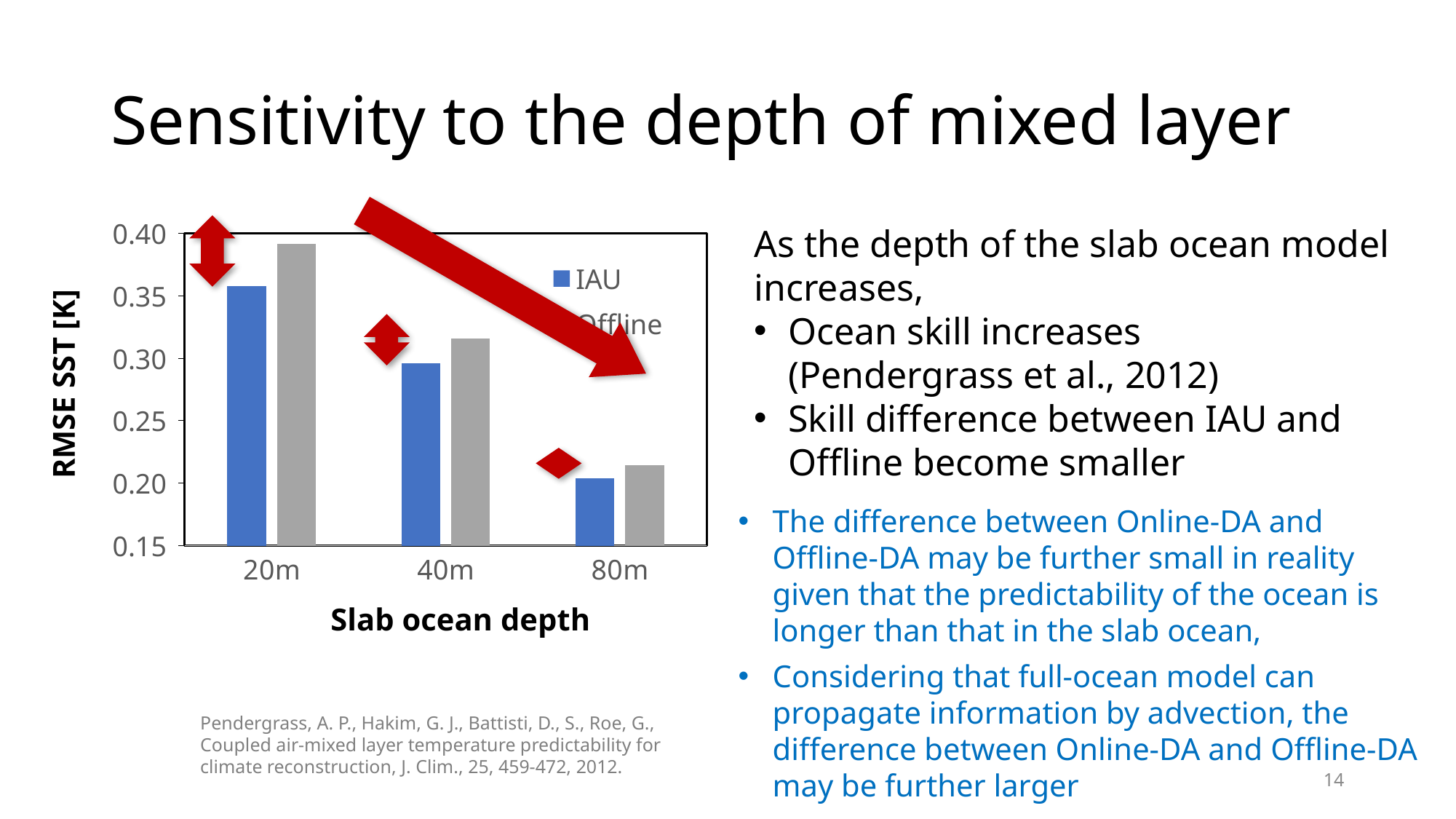
Is the Offline value at 80m greater or less than 0.25? less What is the label of the vertical axis of the chart? RMSE SST [K] Is the Offline value at 20m greater or less than 0.35? greater How many series does the chart legend list? 2 Do the RMSE SST values rise or fall as the slab ocean depth increases from 20m to 80m? fall What kind of chart is shown on the slide? bar chart Which bar is the highest in the chart? Offline at 20m At 40m, which series has the larger RMSE SST, IAU or Offline? Offline At 20m, which series has the larger RMSE SST, IAU or Offline? Offline Is the IAU value at 40m greater or less than 0.35? less How many slab ocean depth categories are shown on the x axis? 3